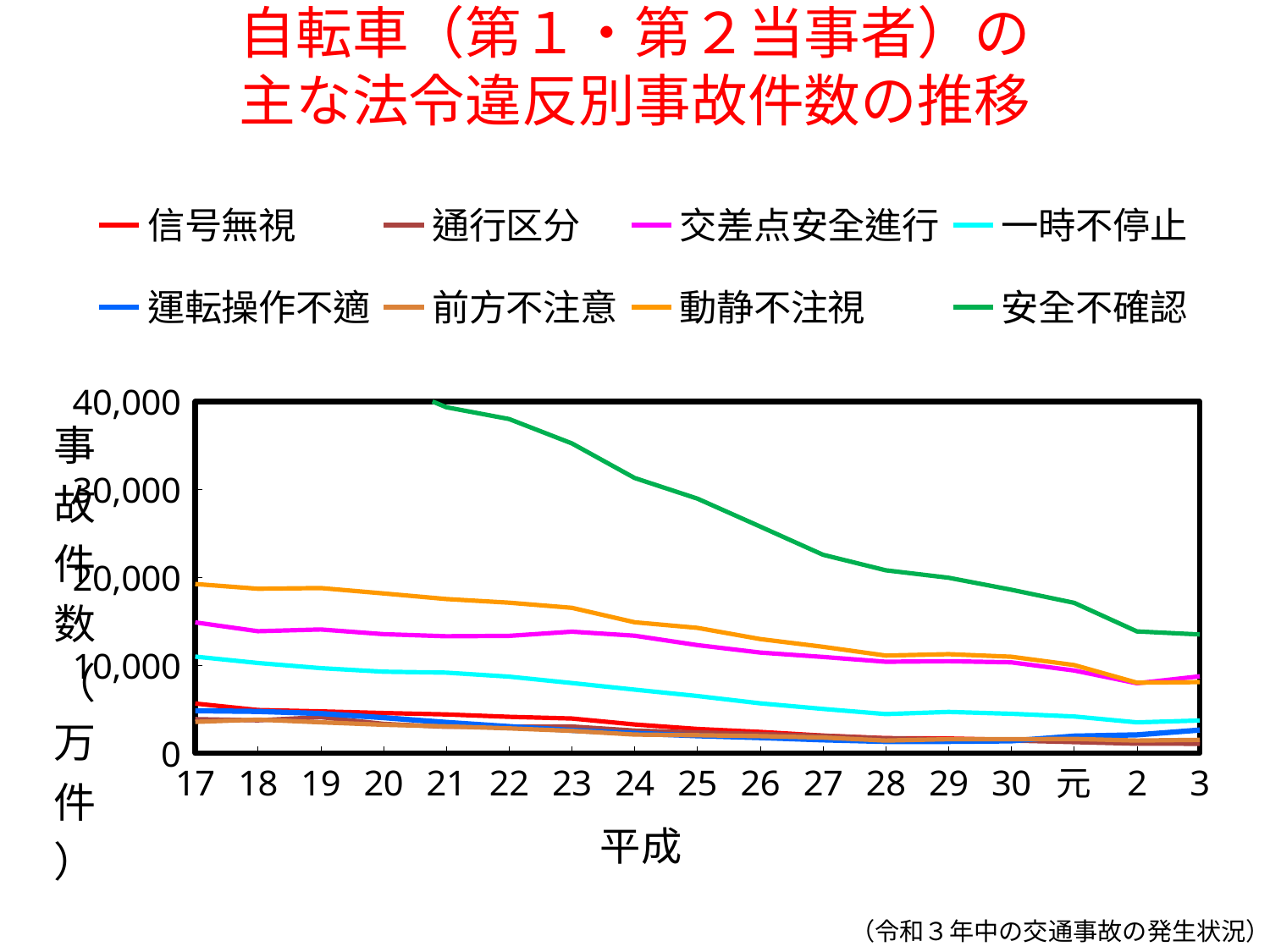
How many series does the legend list? 8 Is the value for 安全不確認 in 平成27 greater or less than 20,000? greater In 平成25, which is larger: 安全不確認 or 動静不注視? 安全不確認 Is the value for 動静不注視 in 平成17 greater or less than 20,000? less Is the value for 安全不確認 in 令和3 greater or less than 10,000? greater What colour is the line for 安全不確認? green Does the 安全不確認 series rise or fall from 平成21 to 令和3? fall How many points are plotted along the x axis for each series? 17 What kind of chart is shown on the slide? line chart Which series has the highest values across the chart? 安全不確認